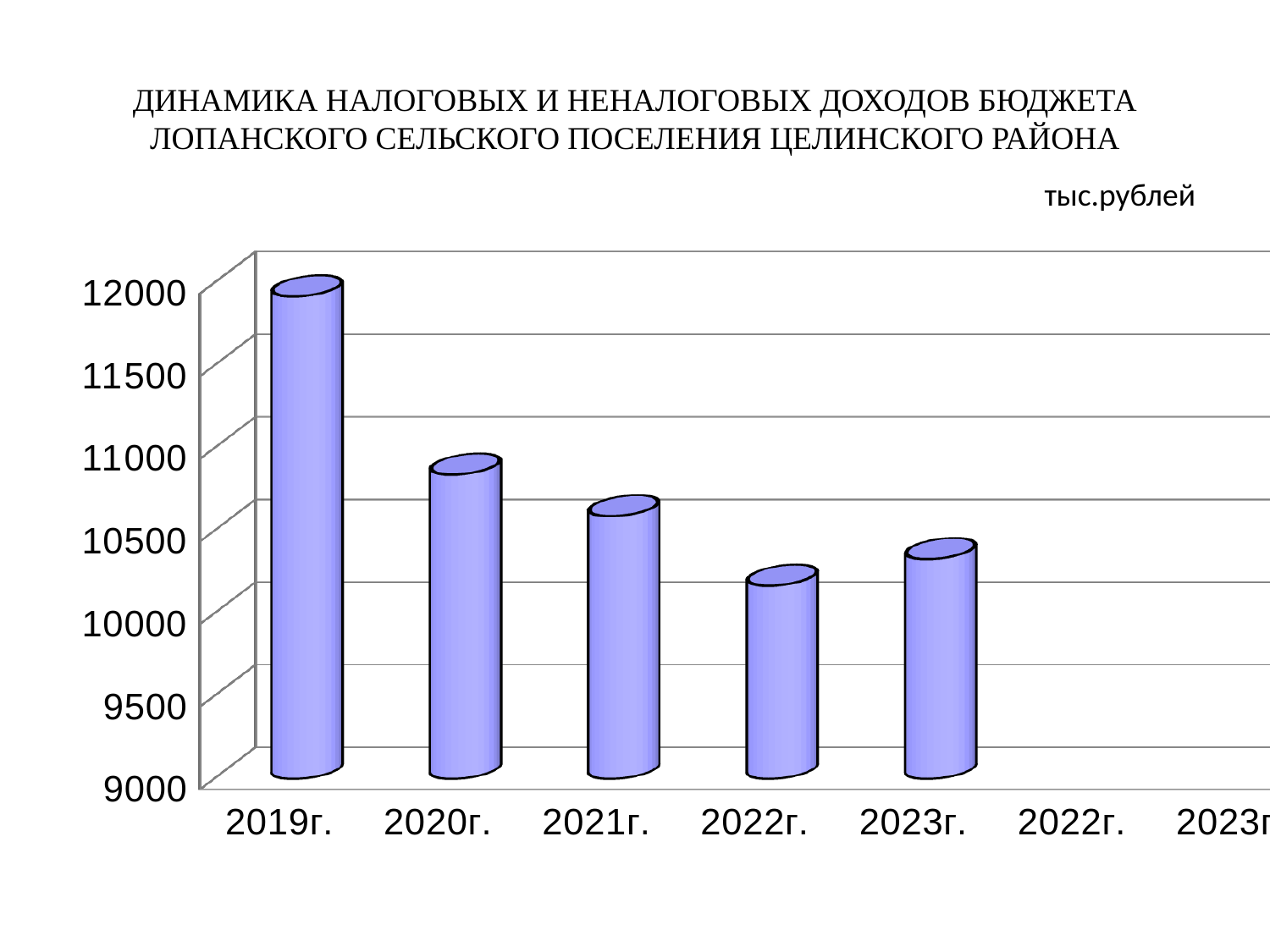
Is the value for 2021г. greater or less than 11000? less Is the value for 2023г. greater or less than 10000? greater Which year has the lowest value? 2022г. Is the value for 2019г. greater or less than 11500? greater Do the values rise or fall from 2019г. to 2022г.? fall Which is larger, the value for 2019г. or the value for 2020г.? 2019г. Which is larger, the value for 2022г. or the value for 2023г.? 2023г. In what units are the values given, according to the label above the chart? тыс.рублей What kind of chart is shown on the slide? bar chart Which year has the highest value? 2019г.